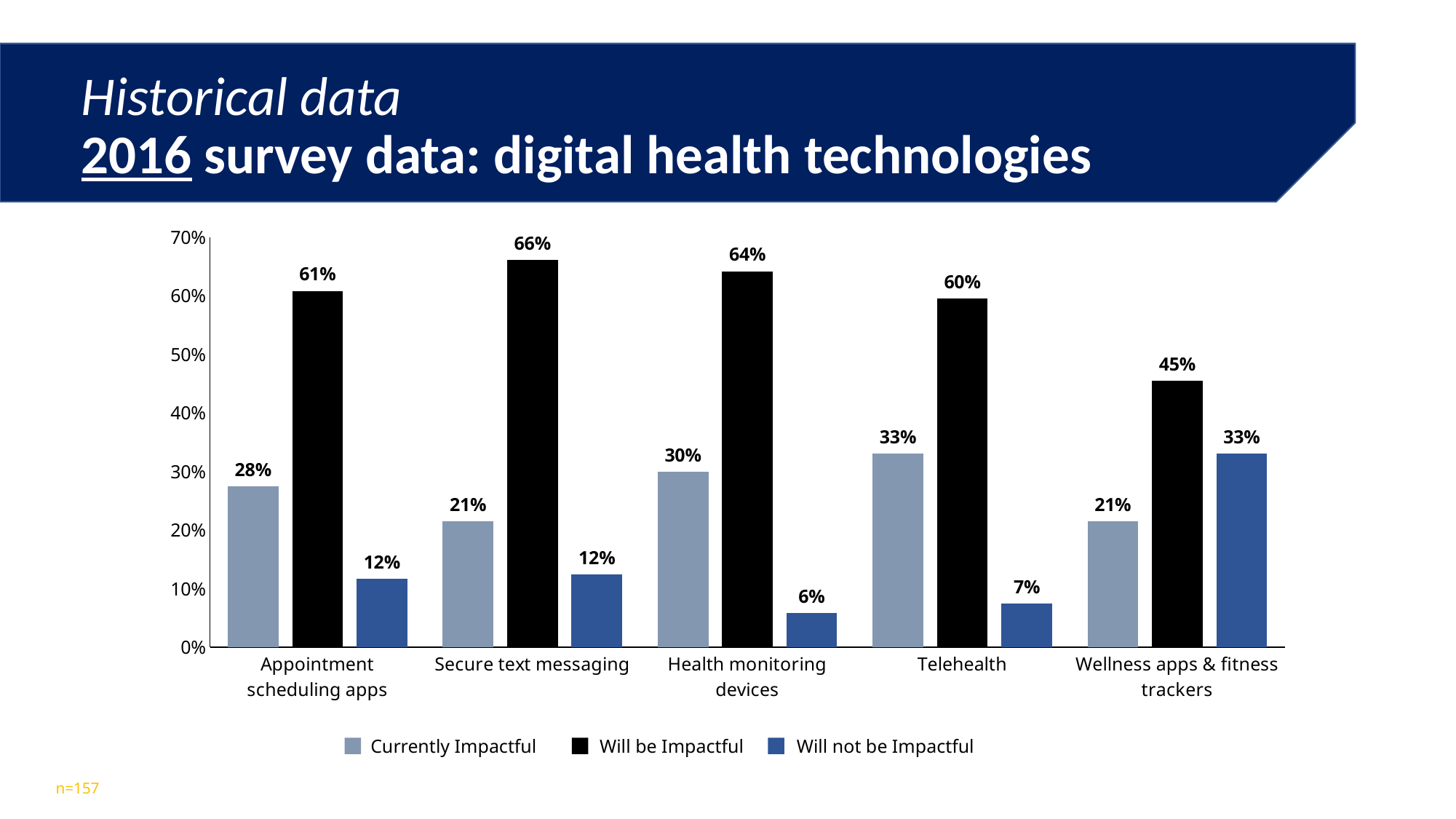
What colour are the 'Will be Impactful' bars? Black Which category has the lowest 'Will not be Impactful' value? Health monitoring devices How many categories are shown on the x axis? 5 What is the 'Will be Impactful' value for Secure text messaging? 66% What kind of chart is shown on the slide? Bar chart How many series does the legend list? 3 What is the 'Will not be Impactful' value for Health monitoring devices? 6% Which category has the highest 'Will be Impactful' value? Secure text messaging What is the difference between the 'Will be Impactful' and 'Currently Impactful' values for Appointment scheduling apps? 33% What is the 'Currently Impactful' value for Telehealth? 33% Is the 'Will be Impactful' value for Wellness apps & fitness trackers greater or less than 50%? less Which is larger for Wellness apps & fitness trackers: 'Currently Impactful' or 'Will not be Impactful'? Will not be Impactful